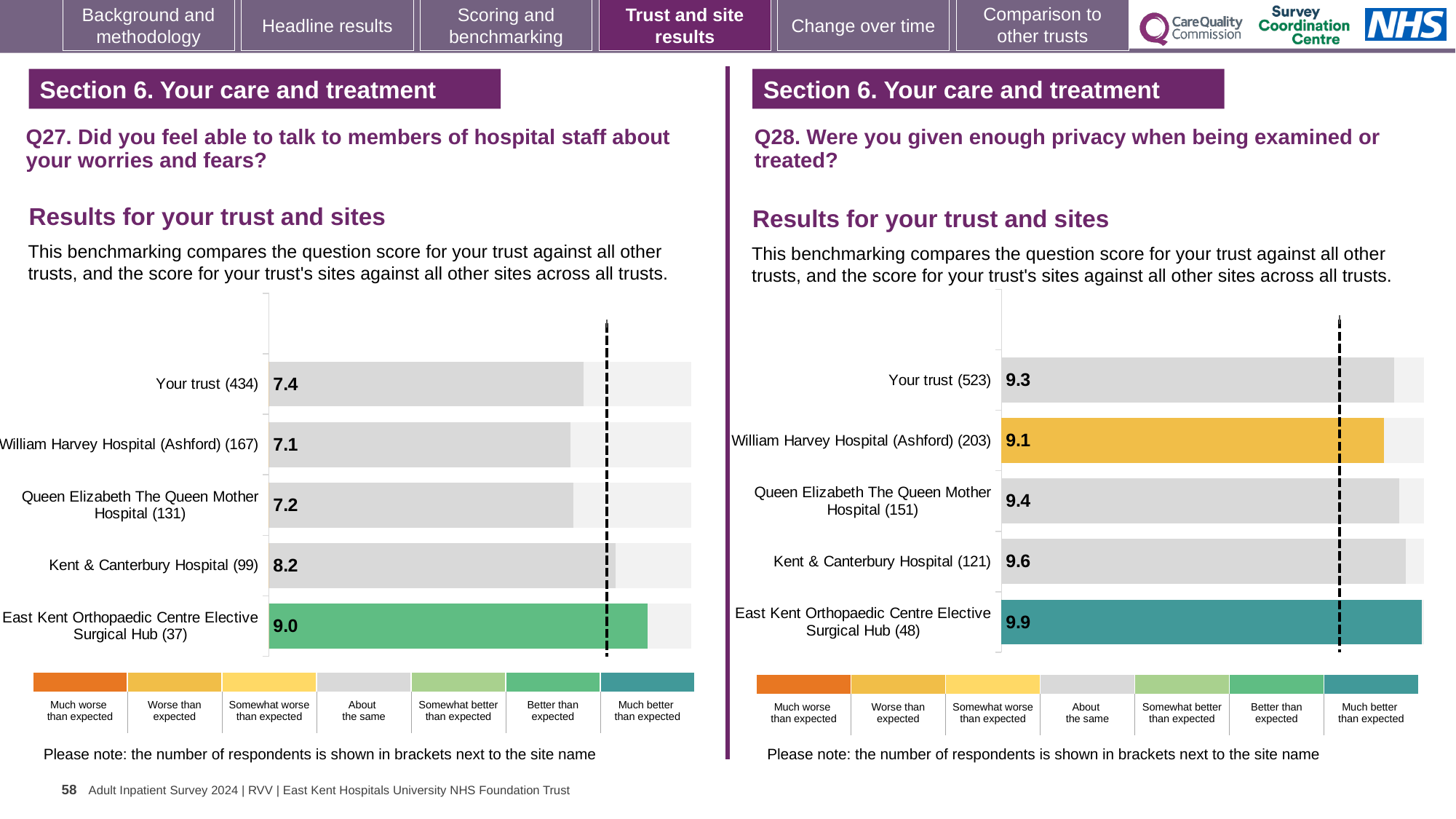
On the Q28 chart (right), what is the score for Queen Elizabeth The Queen Mother Hospital (151)? 9.4 What type of chart is used on the Q27 chart (left)? Bar chart On the Q27 chart (left), which site has the highest score? East Kent Orthopaedic Centre Elective Surgical Hub (37) On the Q28 chart (right), what is the score for William Harvey Hospital (Ashford) (203)? 9.1 On the Q27 chart (left), what is the score for Kent & Canterbury Hospital (99)? 8.2 On the Q27 chart (left), how many bars are plotted? 5 On the Q27 chart (left), what is the score for Your trust (434)? 7.4 On the Q27 chart (left), what is the difference between the scores for East Kent Orthopaedic Centre Elective Surgical Hub (37) and Your trust (434)? 1.6 On the Q28 chart (right), which is larger: the score for Kent & Canterbury Hospital (121) or Your trust (523)? Kent & Canterbury Hospital (121) On the Q28 chart (right), what is the difference between the scores for East Kent Orthopaedic Centre Elective Surgical Hub (48) and William Harvey Hospital (Ashford) (203)? 0.8 On the Q28 chart (right), which site has the highest score? East Kent Orthopaedic Centre Elective Surgical Hub (48) On the Q27 chart (left), which site has the lowest score? William Harvey Hospital (Ashford) (167)